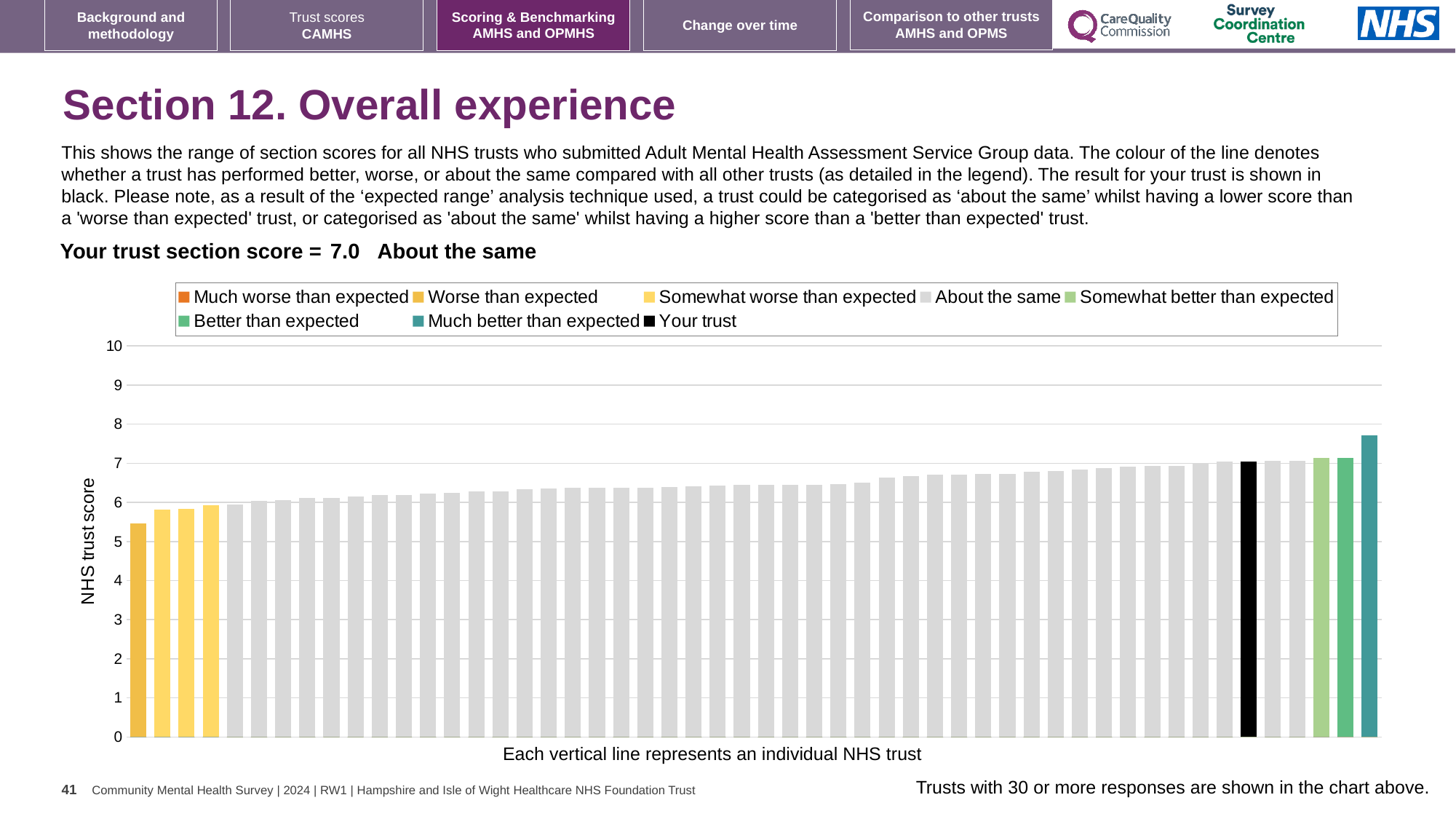
Which legend category does the tallest bar in the chart belong to? Much better than expected What is the label on the vertical axis of the chart? NHS trust score What is the section score for your trust shown on the slide? 7.0 Is the value of the tallest bar in the chart greater or less than 8? less Do the bar values rise or fall from left to right across the chart? rise Which is larger: the score for your trust or the score of the leftmost bar? your trust Which legend category does the shortest bar in the chart belong to? Worse than expected How many bars in the chart are coloured as 'Worse than expected'? 1 Is the value of the shortest bar in the chart greater or less than 6? less What kind of chart is shown on the slide? bar chart Is the value of the tallest bar in the chart greater or less than 7? greater How many entries does the chart legend list? 8